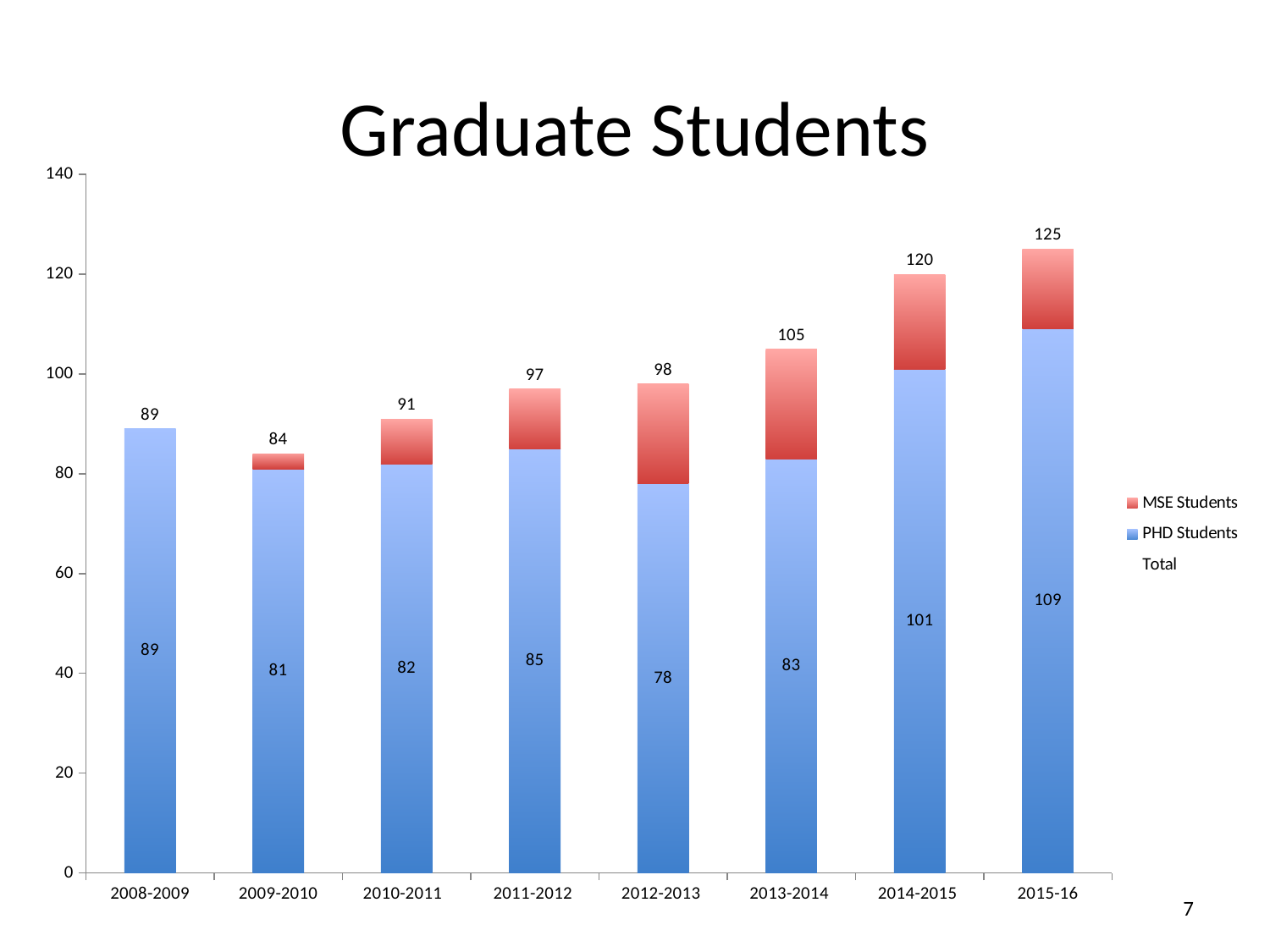
How many entries does the legend list? 3 What is the title of the chart? Graduate Students What type of chart is shown on the slide? Stacked bar chart Which is larger, the number of PHD Students in 2011-2012 or in 2013-2014? 2011-2012 Which year has the lowest number of PHD Students? 2012-2013 Which year has the highest total number of graduate students? 2015-16 Is the total for 2014-2015 greater or less than 100? greater Do the total values generally rise or fall from 2009-2010 to 2015-16? rise What is the difference between the total and the PHD Students value in 2013-2014? 22 How many academic years are shown on the x axis? 8 What is the total number of graduate students in 2012-2013? 98 What is the number of PHD Students in 2014-2015? 101